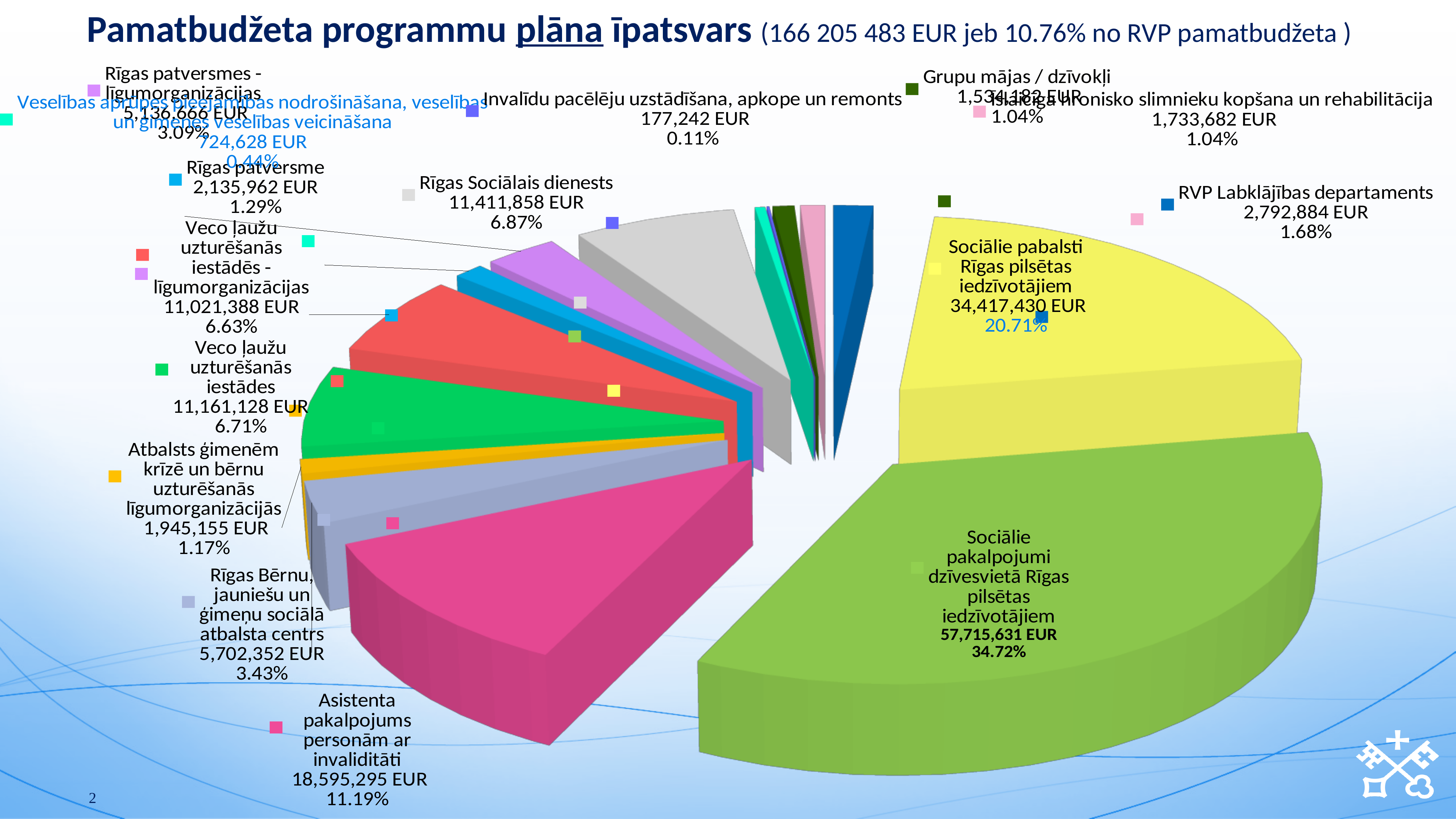
What percentage share is shown for Invalīdu pacēlēju uzstādīšana, apkope un remonts? 0.11% What percentage share is shown for RVP Labklājības departaments? 1.68% What is the difference in percentage points between Sociālie pakalpojumi dzīvesvietā Rīgas pilsētas iedzīvotājiem (34.72%) and Sociālie pabalsti Rīgas pilsētas iedzīvotājiem (20.71%)? 14.01 What is the value shown for Rīgas Sociālais dienests? 11,411,858 EUR Which is larger: Veco ļaužu uzturēšanās iestādes or Veco ļaužu uzturēšanās iestādēs - līgumorganizācijas? Veco ļaužu uzturēšanās iestādes What is the value shown for Sociālie pabalsti Rīgas pilsētas iedzīvotājiem? 34,417,430 EUR What total amount is stated in the chart title? 166 205 483 EUR Which category has the largest share of the pie? Sociālie pakalpojumi dzīvesvietā Rīgas pilsētas iedzīvotājiem Which category has the smallest share of the pie? Invalīdu pacēlēju uzstādīšana, apkope un remonts What is the value shown for Rīgas Bērnu, jauniešu un ģimeņu sociālā atbalsta centrs? 5,702,352 EUR What percentage share is shown for Asistenta pakalpojums personām ar invaliditāti? 11.19% What kind of chart is shown on the slide? pie chart